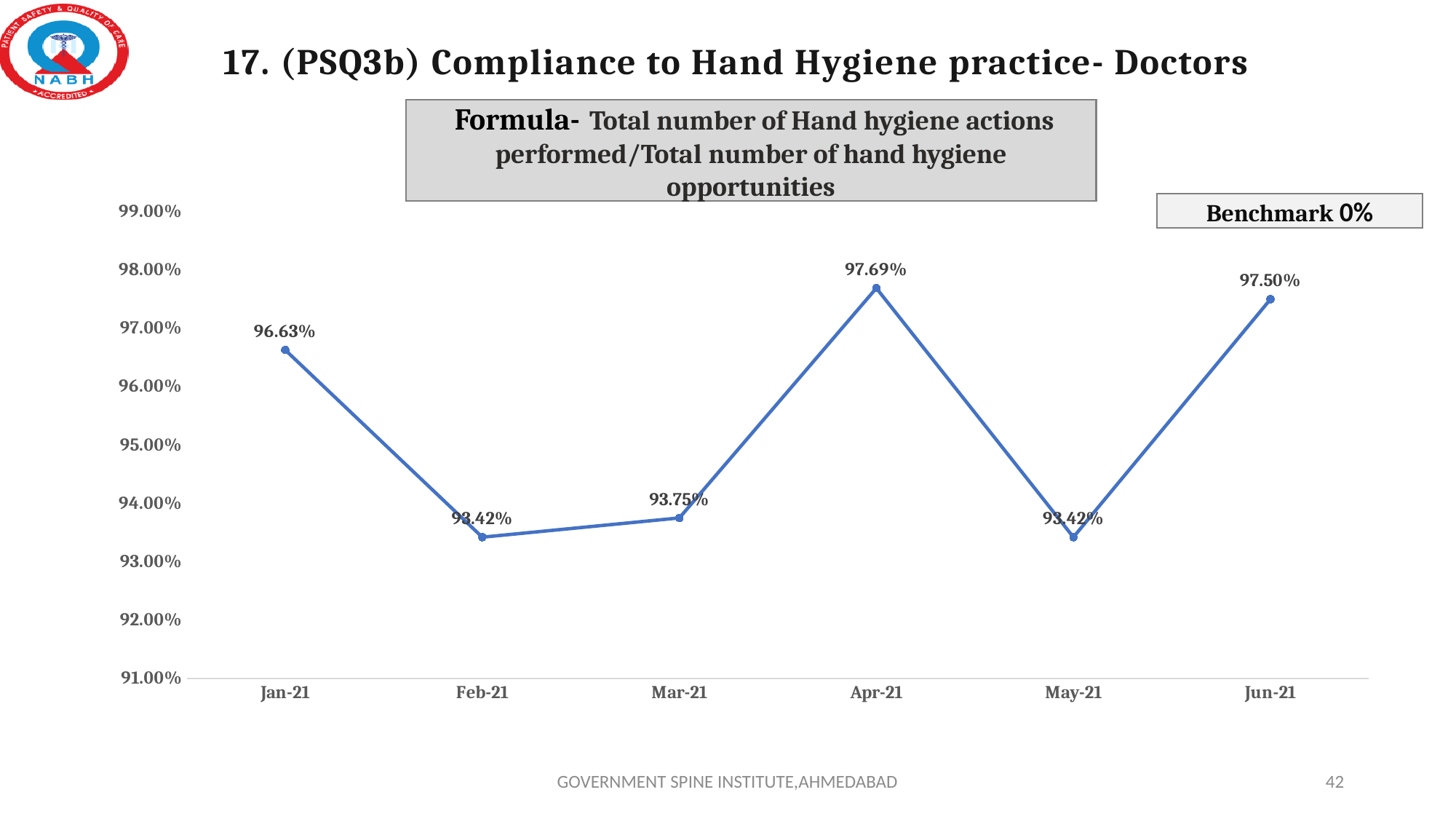
How many months are plotted on the chart? 6 What benchmark value is stated on the slide? 0% What is the difference between the Apr-21 and Jun-21 compliance values? 0.19% What kind of chart is shown on the slide? line chart Which is larger, the compliance value for Jan-21 or for Mar-21? Jan-21 What is the hand hygiene compliance value for Doctors in Jun-21? 97.50% What is the difference between the Jan-21 and Feb-21 compliance values? 3.21% What is the hand hygiene compliance value for Doctors in Mar-21? 93.75% What is the hand hygiene compliance value for Doctors in Jan-21? 96.63% Is the compliance value for May-21 greater or less than 94.00%? less What is the hand hygiene compliance value for Doctors in Apr-21? 97.69% Which month has the highest hand hygiene compliance value? Apr-21